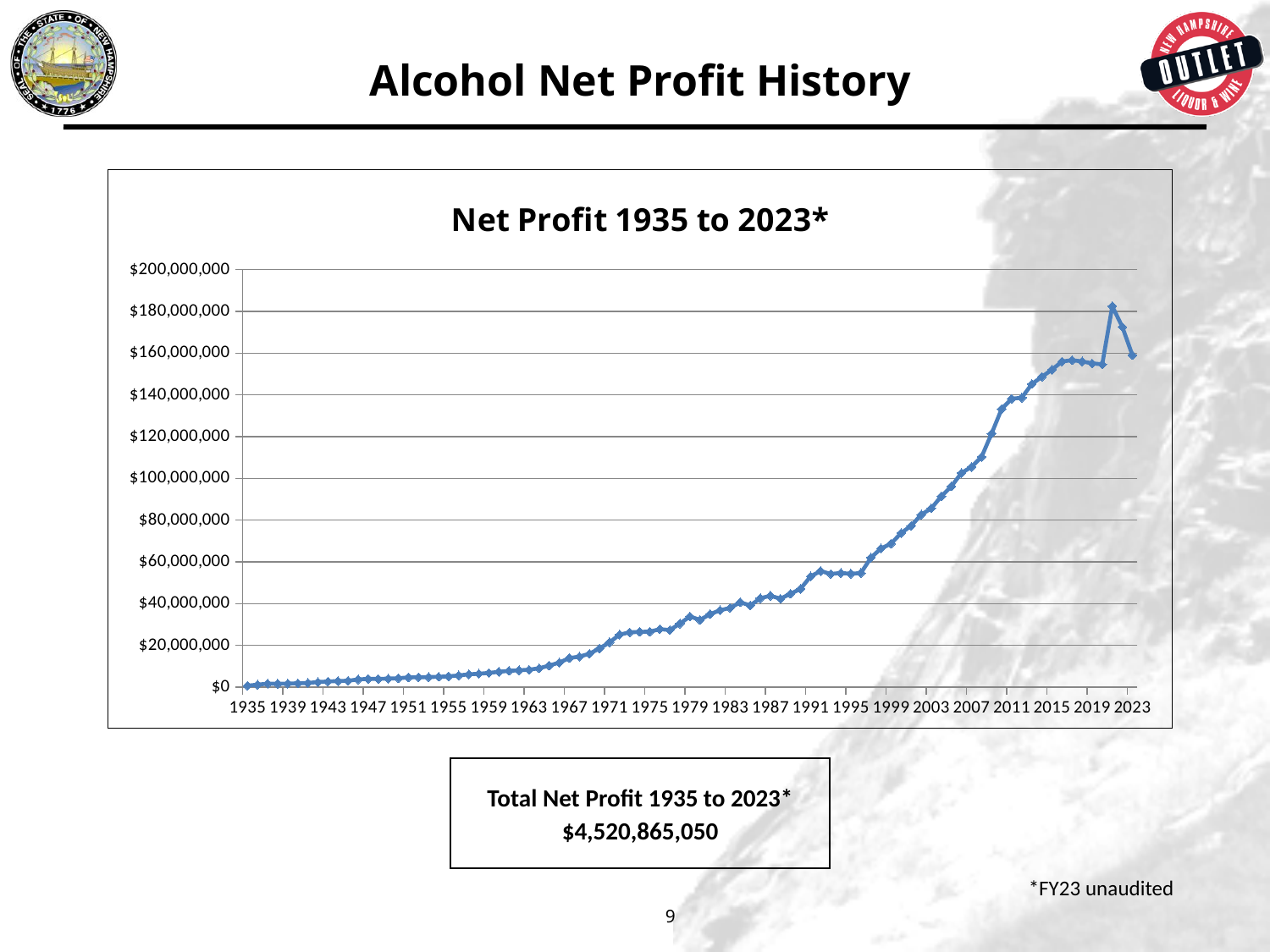
Is the net profit value for 2003 greater or less than $100,000,000? less Is the net profit value for 2023 greater or less than $140,000,000? greater What is the title of the chart? Net Profit 1935 to 2023* In which year does the net profit line reach its highest point? 2021 Is the net profit value for 2007 greater or less than $100,000,000? greater What kind of chart is shown on the slide? line chart What total net profit for 1935 to 2023 is stated in the box below the chart? $4,520,865,050 Which year has the larger net profit, 1995 or 2015? 2015 Overall, do net profit values rise or fall from 1935 to 2023 along the x axis? rise